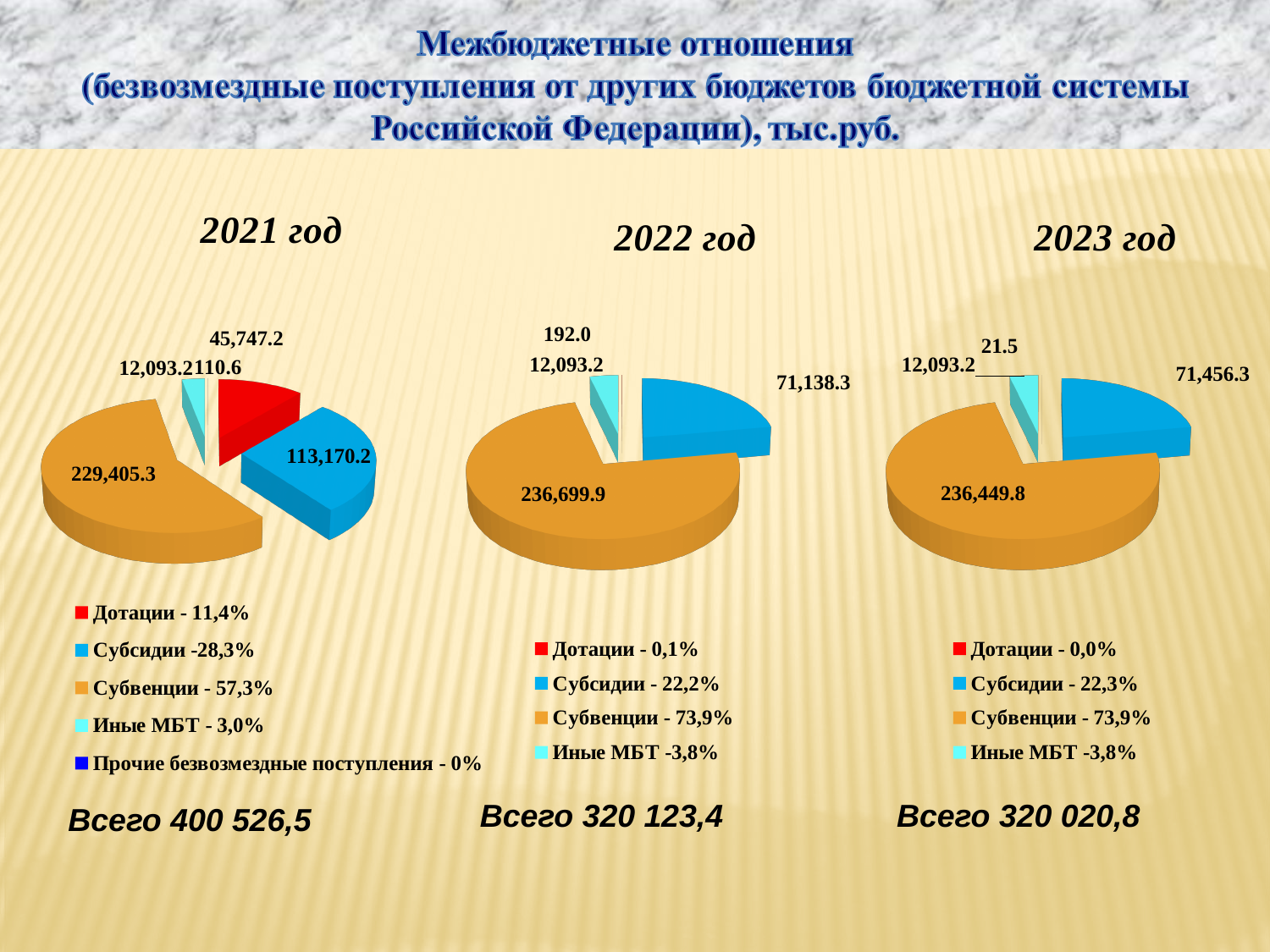
In the 2021 год pie chart, what is the difference between the Субсидии value (113,170.2) and the Дотации value (45,747.2)? 67,423.0 In the 2021 год pie chart, which category has the largest slice? Субвенции How many categories does the legend of the 2021 год chart list? 5 According to the legend of the 2023 год chart, what share of the total do Субвенции make up? 73,9% In the 2023 год pie chart, what is the value of the Дотации slice? 21.5 In the 2022 год pie chart, which category has the smallest slice? Дотации In the 2021 год pie chart, what is the value of the Субвенции slice? 229,405.3 According to the legend of the 2021 год chart, what share of the total do Субсидии make up? 28,3% What total (Всего) is shown under the 2022 год chart? 320 123,4 Which is larger: the Субсидии value in the 2022 год chart or the Субсидии value in the 2023 год chart? 2023 год (71,456.3) In the 2022 год pie chart, what is the value of the Субсидии slice? 71,138.3 What type of chart is used for each year on this slide? Pie chart